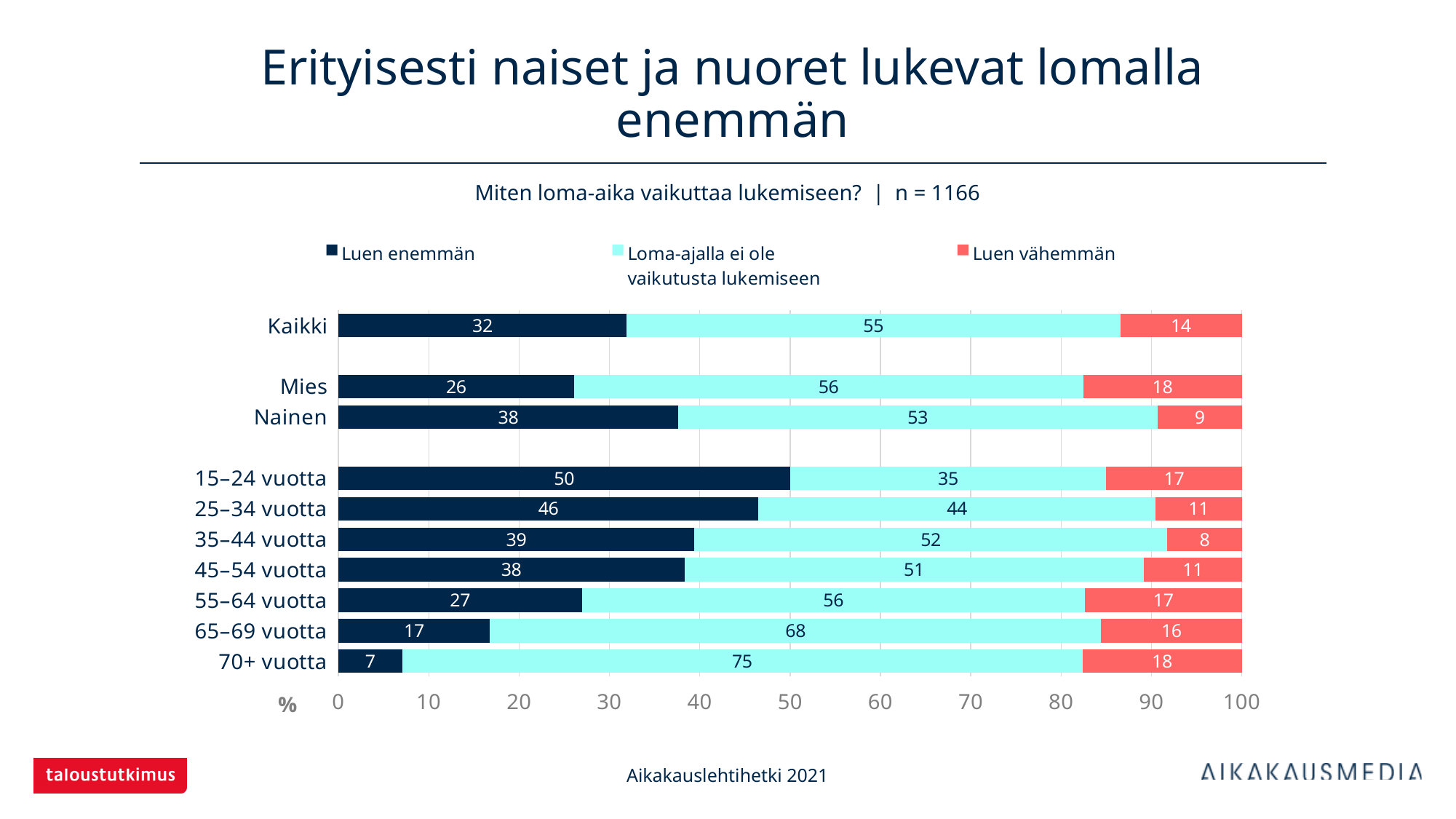
Which is larger: the "Luen enemmän" value for 25–34 vuotta or for 45–54 vuotta? 25–34 vuotta How many categories are shown on the y axis? 10 What is the sample size (n) stated in the chart subtitle? 1166 What is the value of "Luen enemmän" for Nainen? 38 Which category has the lowest value for "Luen vähemmän"? 35–44 vuotta What is the value of "Loma-ajalla ei ole vaikutusta lukemiseen" for 70+ vuotta? 75 Which category has the highest value for "Luen enemmän"? 15–24 vuotta What is the difference between the "Luen enemmän" values for Nainen and Mies? 12 What kind of chart is shown on the slide? Stacked bar chart What is the value of "Luen vähemmän" for Mies? 18 How many series does the legend list? 3 Across the age groups from 15–24 vuotta to 70+ vuotta, does the "Luen enemmän" value rise or fall? Fall